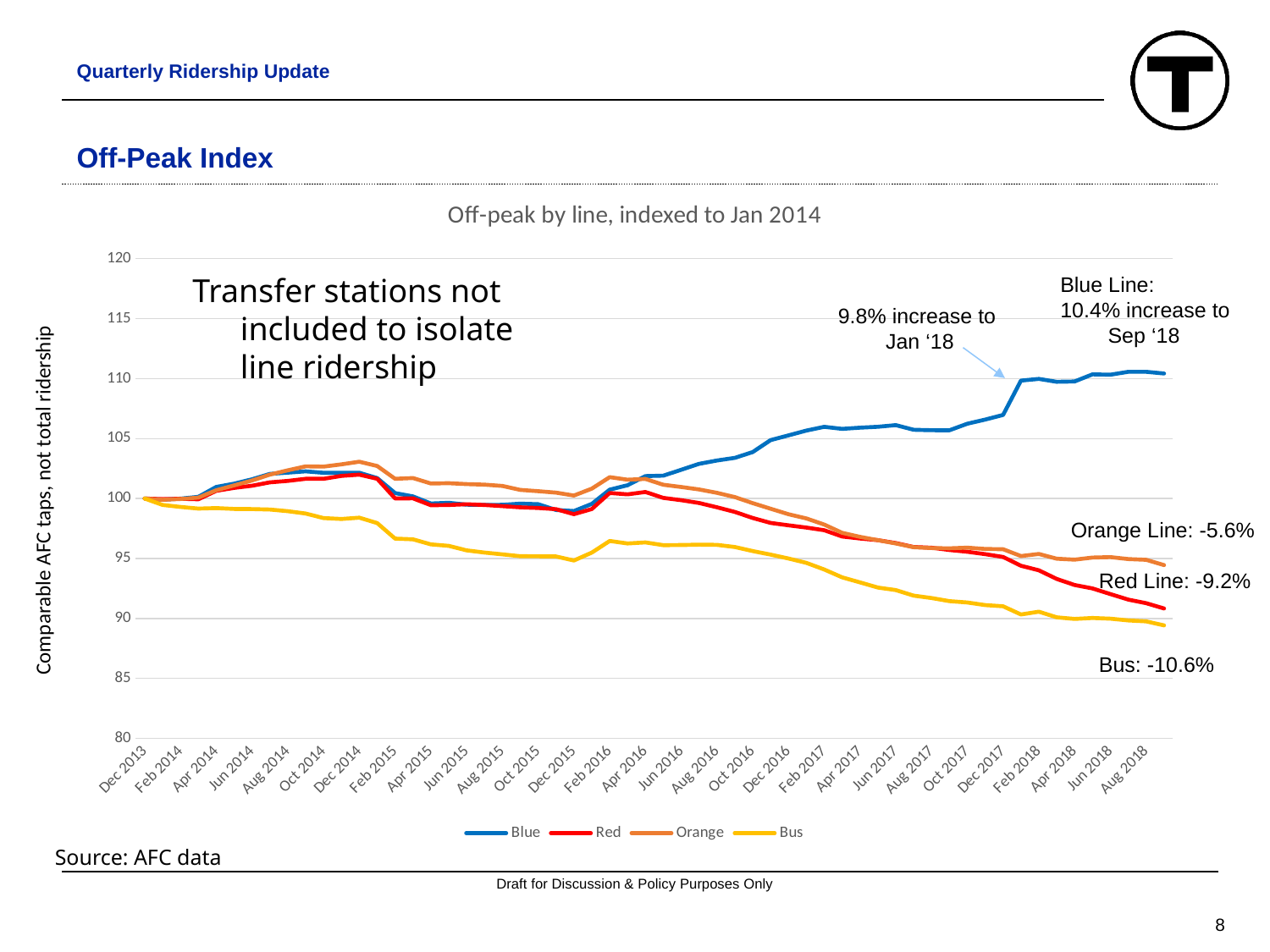
According to the annotation, what is the change shown for the Orange Line? -5.6% According to the annotation, what is the change shown for Bus? -10.6% Which series has the highest value at the end of the chart (Aug 2018)? Blue Is the value for Blue in Aug 2018 greater or less than 105? greater According to the annotation, what is the Blue Line's increase to Sep '18? 10.4% increase How many series does the legend list? 4 At Aug 2018, which is larger, the Orange value or the Red value? Orange Does the Blue series rise or fall overall from Dec 2013 to Aug 2018? Rise What is the title of the chart? Off-peak by line, indexed to Jan 2014 According to the annotation, what is the change shown for the Red Line? -9.2% Which series has the lowest value at the end of the chart (Aug 2018)? Bus What kind of chart is shown on the slide? Line chart